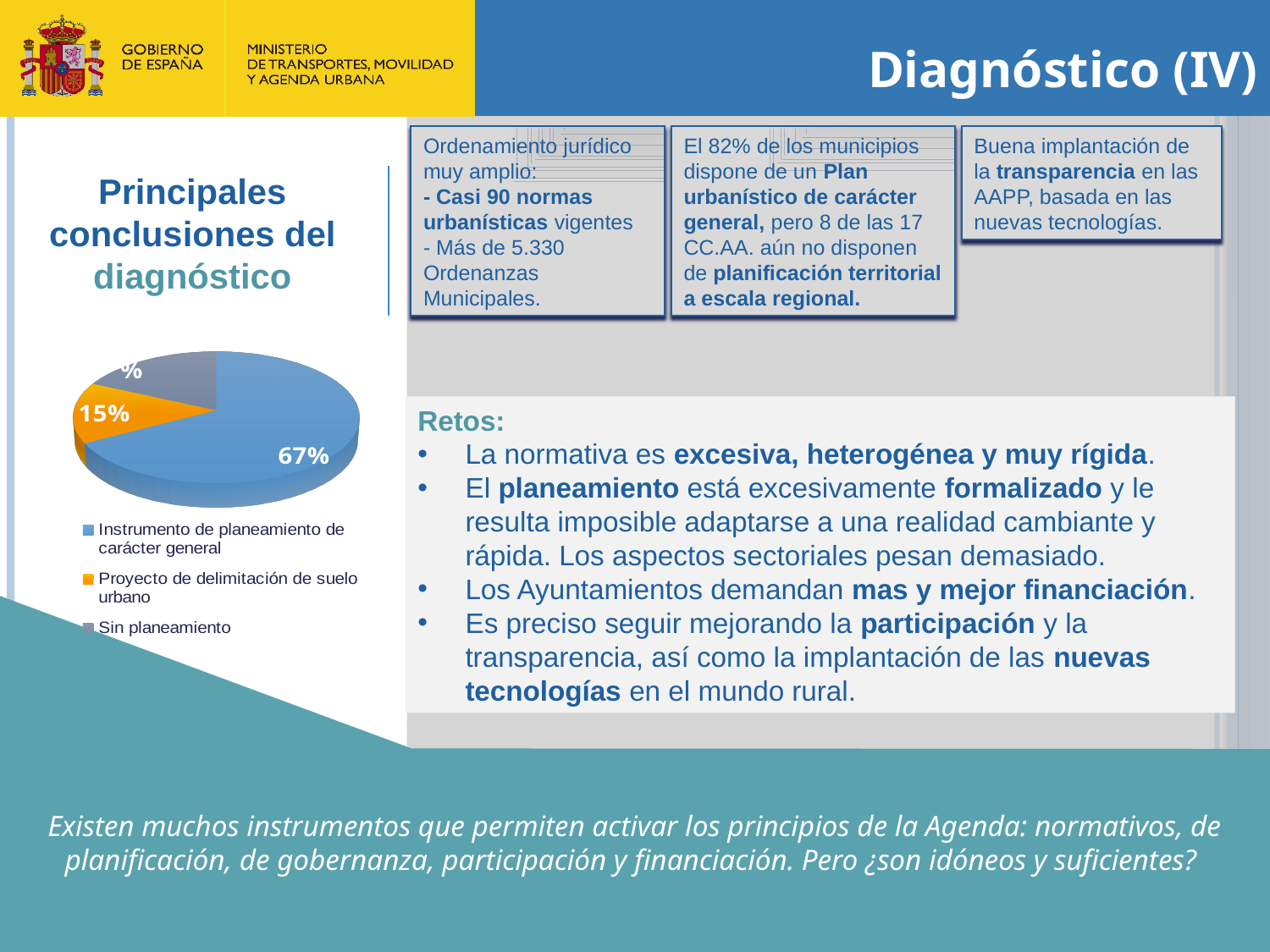
What colour is the slice for 'Proyecto de delimitación de suelo urbano'? Orange How many categories does the pie chart show? 3 By how many percentage points does the 'Instrumento de planeamiento de carácter general' slice exceed the 'Proyecto de delimitación de suelo urbano' slice? 52 percentage points Which legend entry is shown in grey? Sin planeamiento What percentage of the pie corresponds to 'Proyecto de delimitación de suelo urbano'? 15% How many entries does the legend of the pie chart list? 3 Which category has the largest slice of the pie? Instrumento de planeamiento de carácter general What percentage of the pie corresponds to 'Instrumento de planeamiento de carácter general'? 67% What kind of chart is shown on the slide? Pie chart Which is larger: the slice for 'Instrumento de planeamiento de carácter general' or the slice for 'Proyecto de delimitación de suelo urbano'? Instrumento de planeamiento de carácter general What share of the pie does 'Instrumento de planeamiento de carácter general' represent? 67%